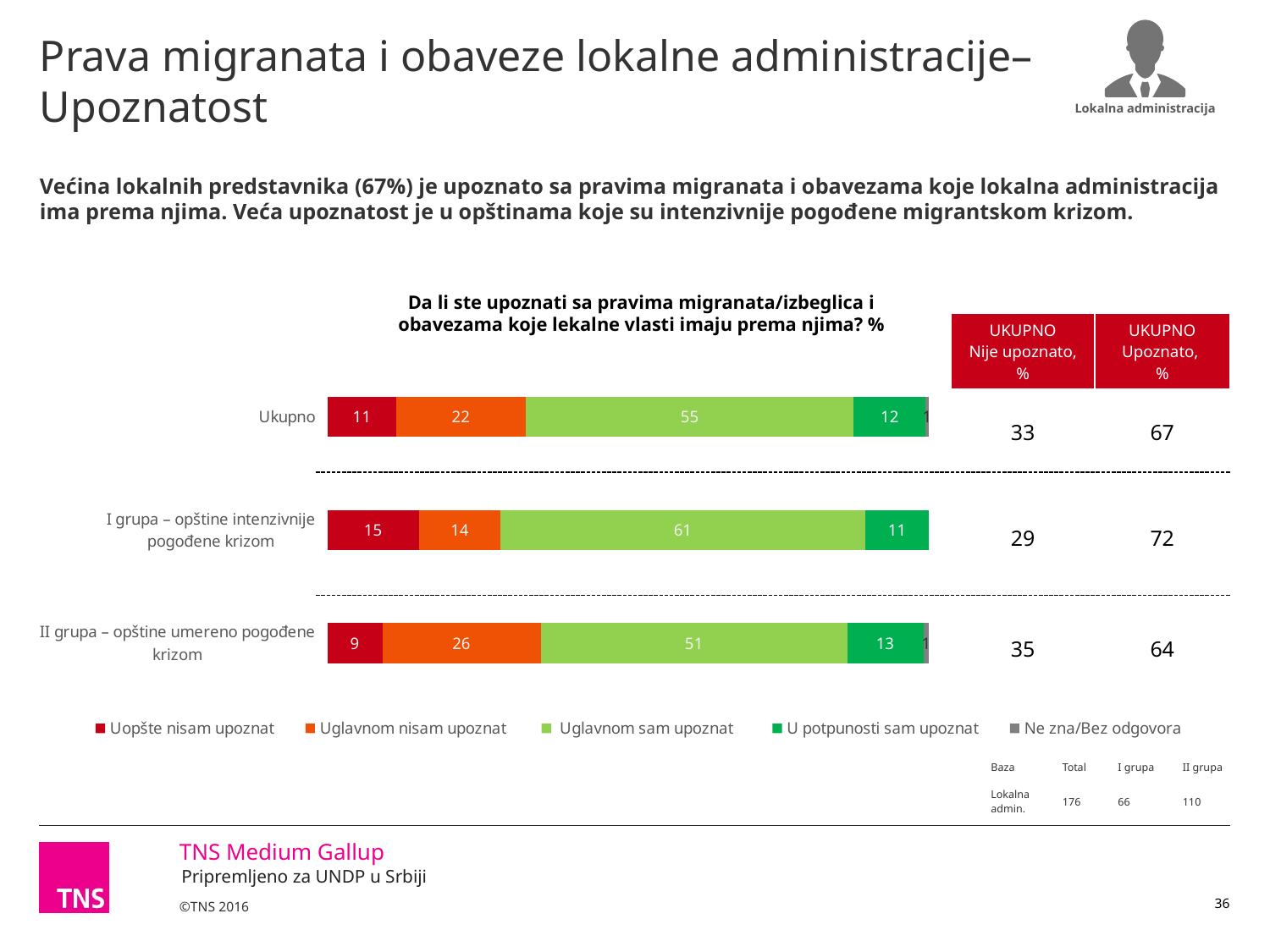
What is the value for "Uglavnom sam upoznat" in the "Ukupno" row? 55 How many categories (rows) does the chart show? 3 What is the value for "Uglavnom nisam upoznat" in the "II grupa – opštine umereno pogođene krizom" row? 26 What kind of chart is shown on the slide? stacked bar chart Which legend entry is shown in orange? Uglavnom nisam upoznat What is the value for "U potpunosti sam upoznat" in the "I grupa – opštine intenzivnije pogođene krizom" row? 11 Which is larger: the "Uglavnom nisam upoznat" value for "Ukupno" or for "I grupa – opštine intenzivnije pogođene krizom"? Ukupno What is the difference between the "Uglavnom sam upoznat" values for "I grupa" and "II grupa"? 10 What is the value for "Uopšte nisam upoznat" in the "I grupa – opštine intenzivnije pogođene krizom" row? 15 How many series does the legend list? 5 Which row has the lowest value for "Uopšte nisam upoznat"? II grupa – opštine umereno pogođene krizom Which row has the highest value for "Uglavnom sam upoznat"? I grupa – opštine intenzivnije pogođene krizom